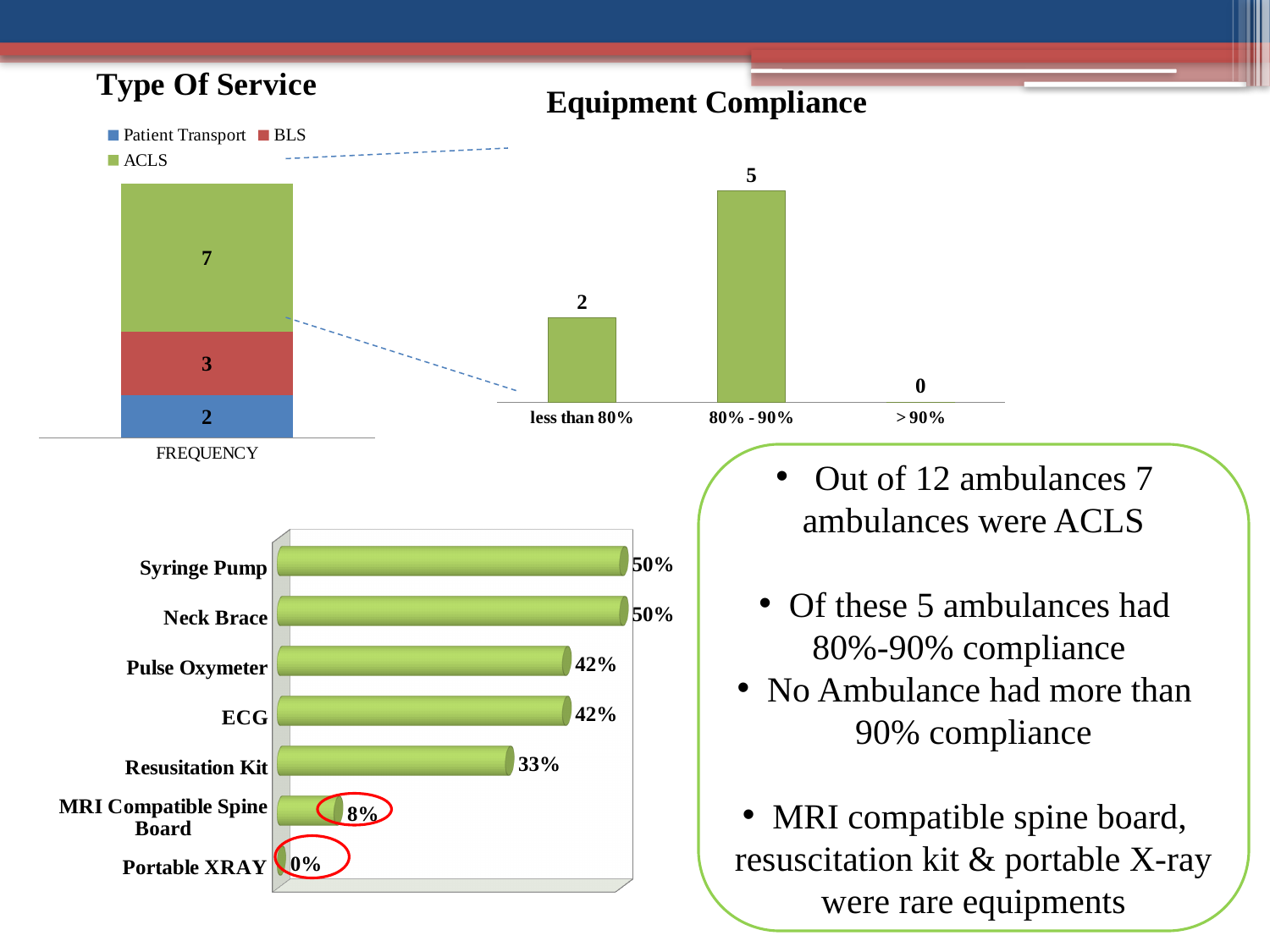
In the Type Of Service chart, what is the total of the stacked bar? 12 In the bottom-left horizontal bar chart, what is the value for Resusitation Kit? 33% How many categories are shown on the x axis of the Equipment Compliance chart? 3 In the Equipment Compliance chart, which category has the lowest value? > 90% In the bottom-left horizontal bar chart, which category has the lowest value? Portable XRAY What kind of chart is the bottom-left chart showing equipment such as Syringe Pump and ECG? Bar chart In the Type Of Service chart, what is the value for BLS? 3 In the bottom-left horizontal bar chart, which is larger, the value for ECG or the value for MRI Compatible Spine Board? ECG In the Type Of Service chart, what is the value for ACLS? 7 In the Equipment Compliance chart, what is the value for 80% - 90%? 5 How many series does the legend of the Type Of Service chart list? 3 In the Equipment Compliance chart, what is the difference between the values for 80% - 90% and less than 80%? 3